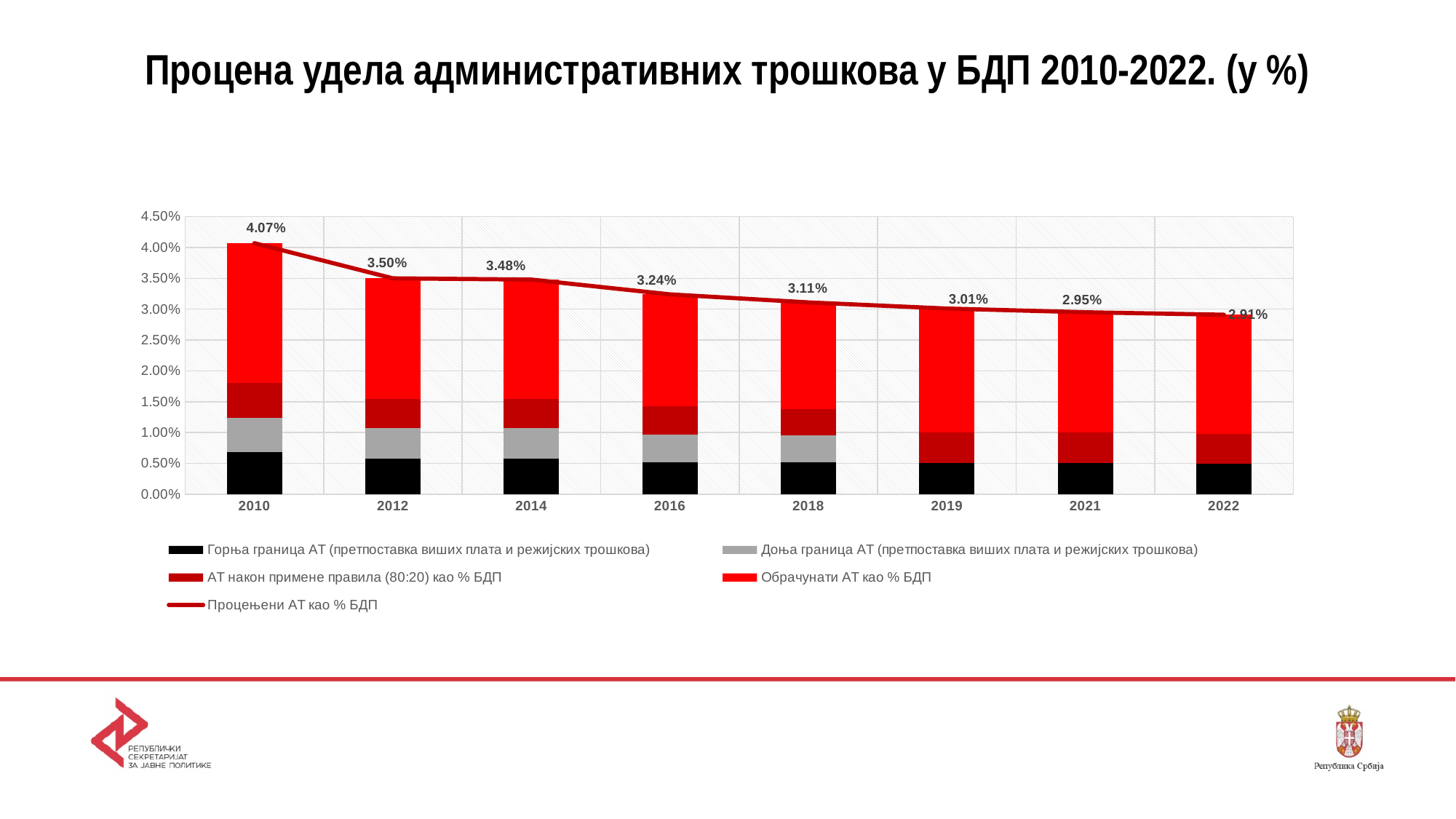
In which year is the Процењени АТ као % БДП value lowest? 2022 What is the value of the Процењени АТ као % БДП line for 2022? 2.91% How many years are shown on the x axis? 8 Does the Процењени АТ као % БДП line rise or fall from 2010 to 2022? Fall Which year has a larger Процењени АТ као % БДП value, 2012 or 2016? 2012 What is the value of the Процењени АТ као % БДП line for 2010? 4.07% Is the value of the black Горња граница АТ segment for 2010 greater or less than 0.50%? greater What is the difference between the Процењени АТ као % БДП values for 2010 and 2022? 1.16% What kind of chart is shown on the slide? Stacked bar chart with a line In which year is the Процењени АТ као % БДП value highest? 2010 What is the value of the Процењени АТ као % БДП line for 2018? 3.11% How many series does the legend list? 5